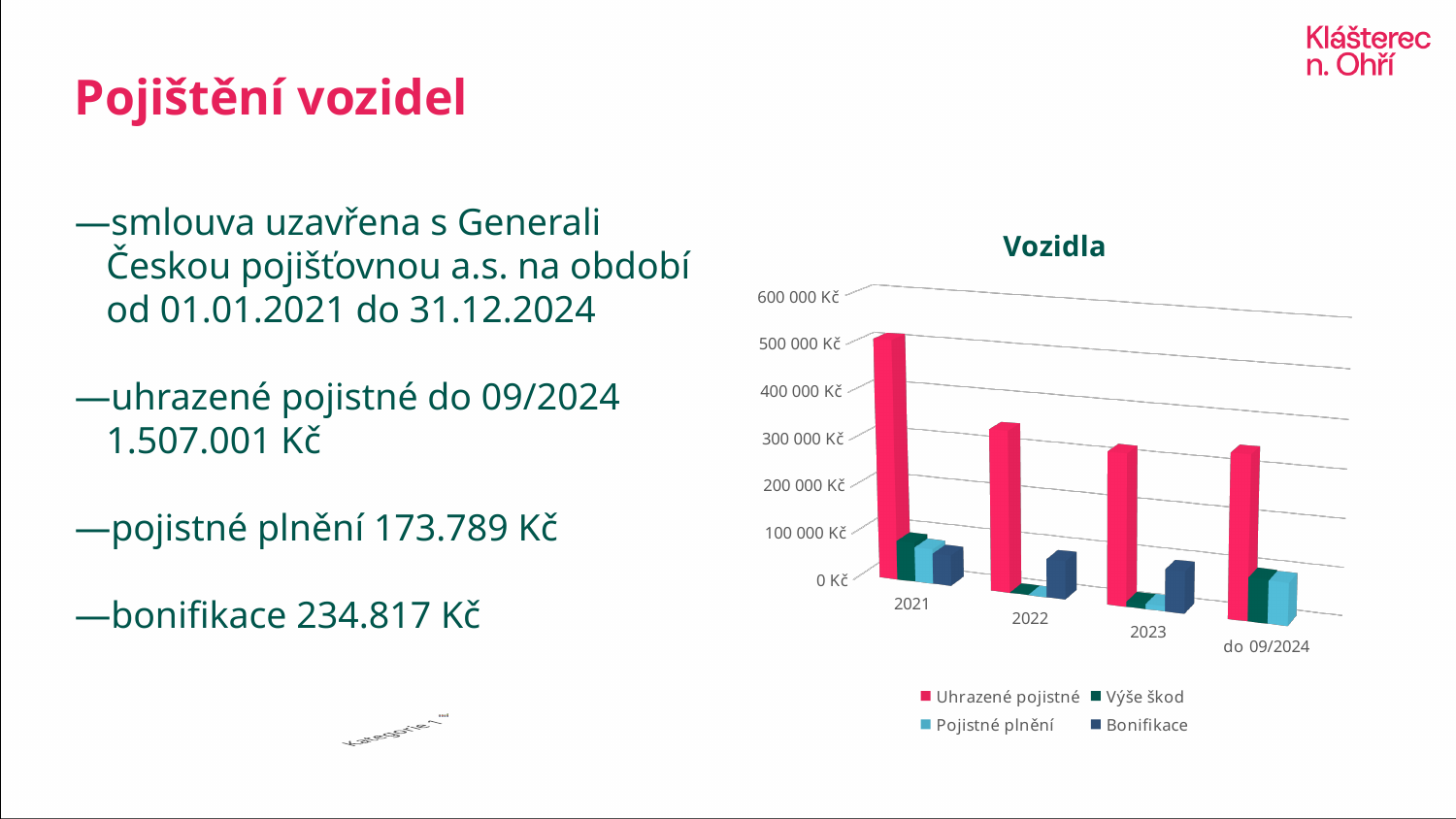
Which is larger, Uhrazené pojistné in 2021 or Uhrazené pojistné in 2022? 2021 Is the value for Bonifikace in 2021 greater or less than 100 000 Kč? less What is the title of the chart? Vozidla Is the value for Uhrazené pojistné in 2021 greater or less than 400 000 Kč? greater Which series is shown in red in the chart legend? Uhrazené pojistné Is the value for Uhrazené pojistné in 2022 greater or less than 400 000 Kč? less What kind of chart is shown on the slide? bar chart Which is larger in 2021, Uhrazené pojistné or Výše škod? Uhrazené pojistné How many categories are shown on the x axis of the chart? 4 In which category is the value for Uhrazené pojistné highest? 2021 How many series does the chart legend list? 4 Does the value for Uhrazené pojistné rise or fall from 2021 to 2023? fall